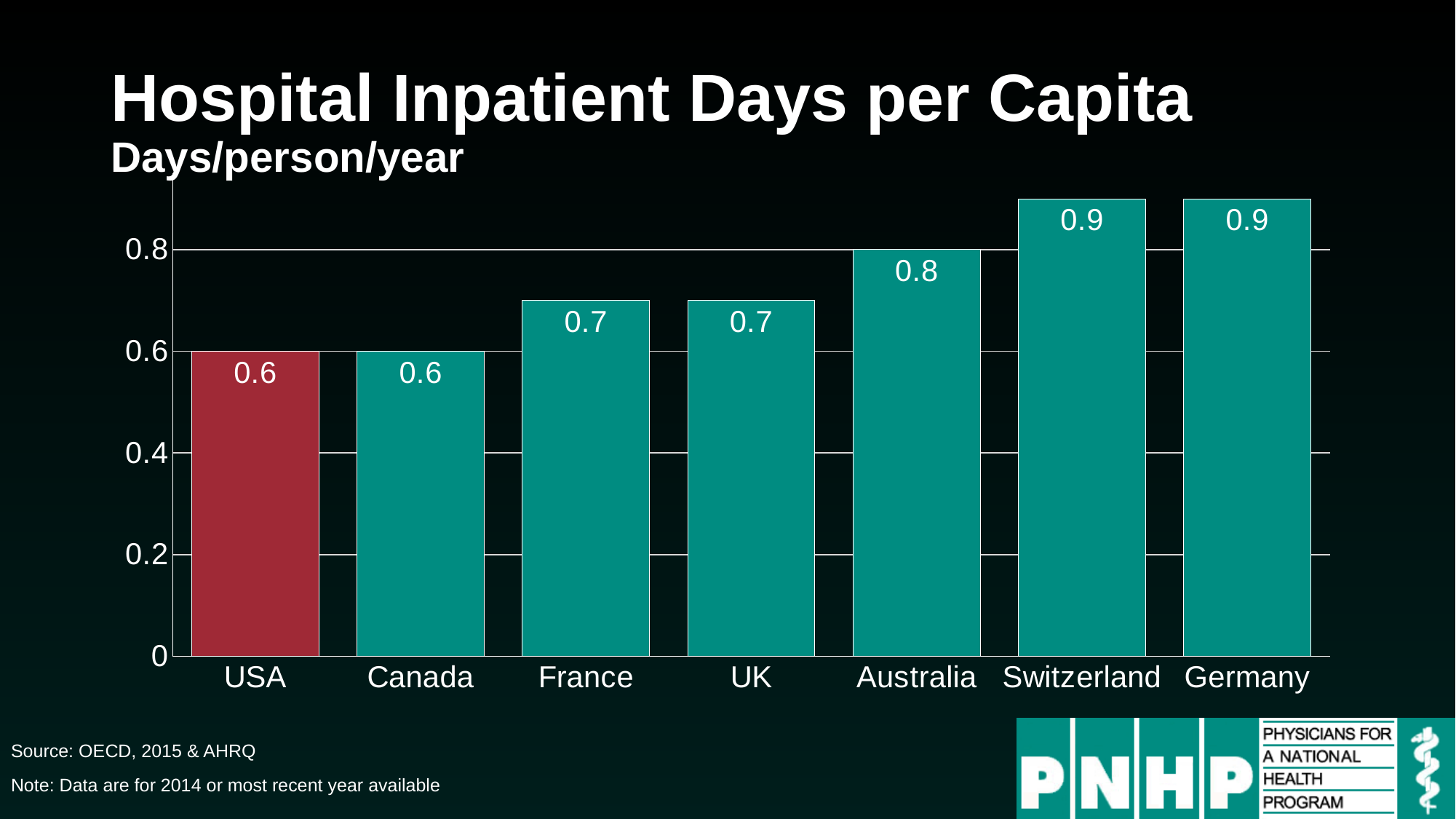
What is the value for Switzerland? 0.9 Which country has the lowest value other than the USA and Canada, which are tied? France and UK (0.7) Which countries share the highest value on the chart? Switzerland and Germany How many countries are shown on the chart? 7 Do the values generally rise or fall from left to right across the countries? Rise What is the value for Australia? 0.8 Which country's bar is coloured differently (red) from the others? USA What is the value for the USA? 0.6 Which is larger, the value for Australia or the value for the UK? Australia What is the value for France? 0.7 What kind of chart is shown on the slide? Bar chart What is the difference between Germany's value and the USA's value? 0.3